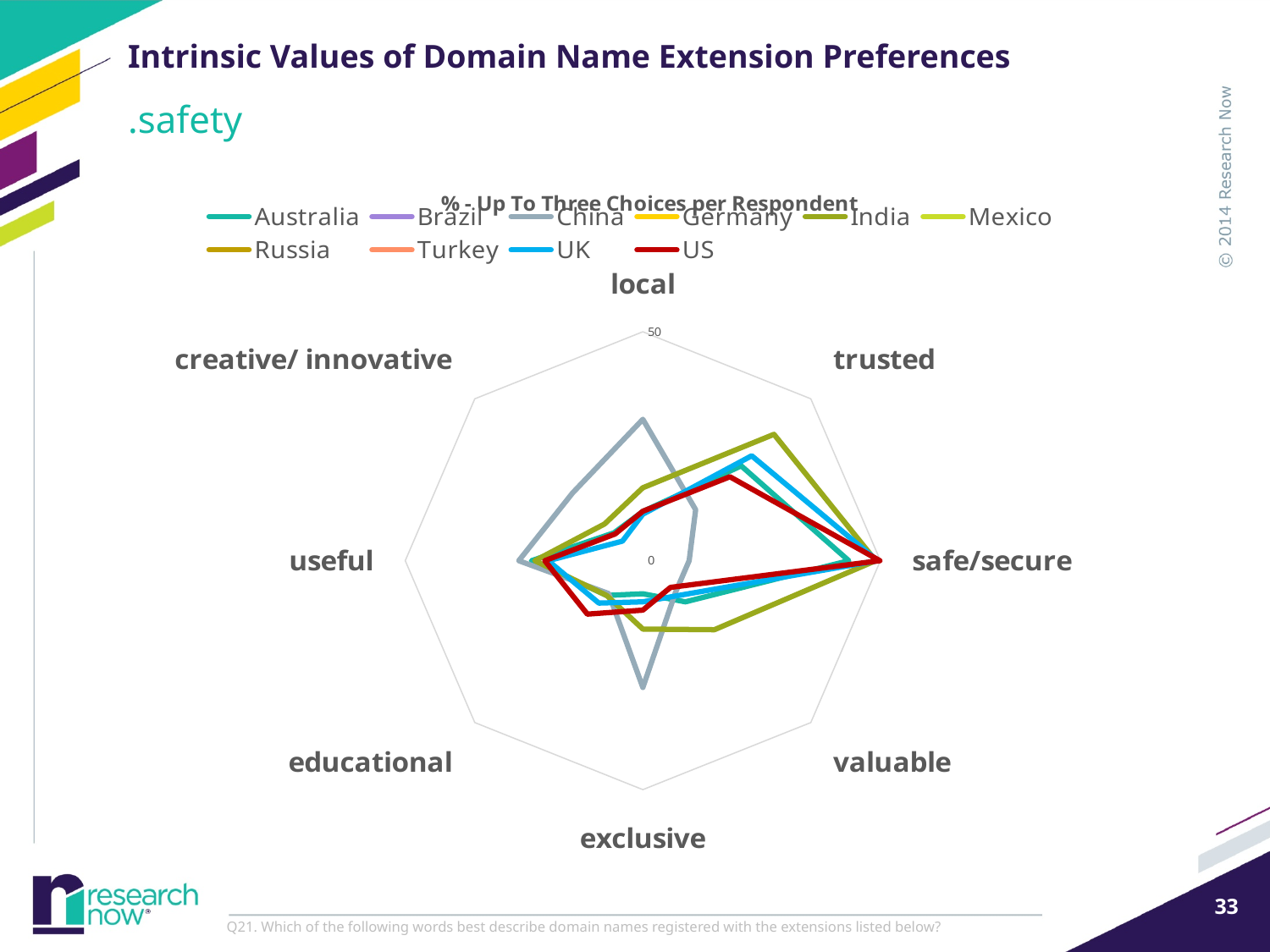
For the US series, is the value for safe/secure or trusted larger? safe/secure How many categories (axes) does the radar chart have? 8 What is the title of the chart? % - Up To Three Choices per Respondent Which domain name extension is this chart about? .safety For the US series, which category has the highest value? safe/secure Which series has the highest value on the educational axis? US What kind of chart is shown on the slide? Radar chart Which series has the highest value on the trusted axis? India How many series does the chart legend list? 10 Is the value for China on the local axis greater or less than 50? less For the China series, is the value for local or trusted larger? local